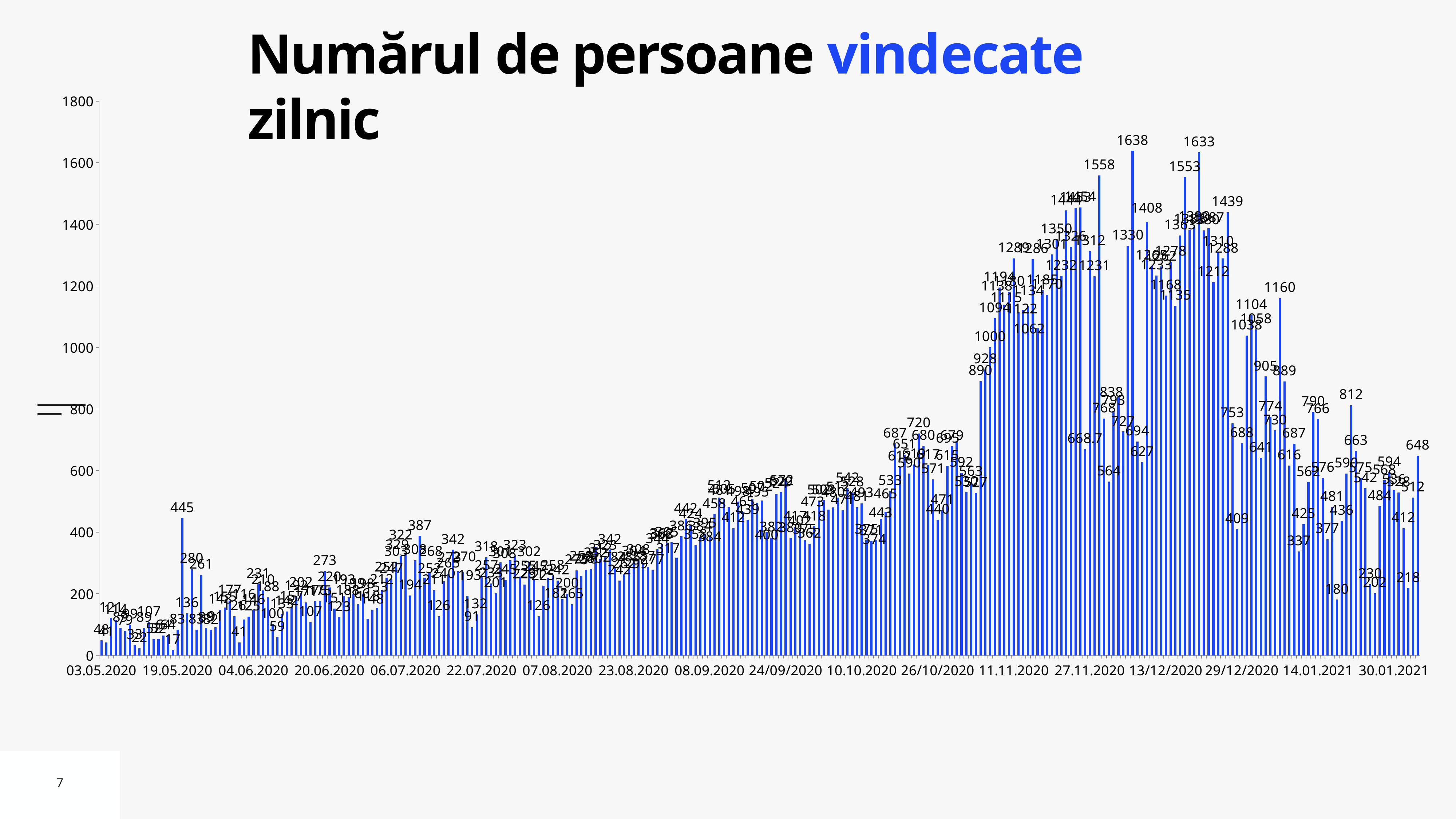
How many date labels are shown along the horizontal axis? 18 What is the difference between the highest labelled value (1638) and the rightmost bar (648)? 990 Is the value of the tallest bar in May 2020 greater or less than 400? greater What is the title of the chart? Numărul de persoane vindecate zilnic What is the difference between the two tallest bars, labelled 1638 and 1633? 5 What kind of chart is shown on the slide? bar chart What is the highest value labelled on the chart? 1638 Do the daily values generally rise or fall from May 2020 to December 2020? rise What is the value of the rightmost bar on the chart? 648 What is the maximum value shown on the vertical axis? 1800 What is the value of the tallest bar in May 2020 (between 03.05.2020 and 04.06.2020)? 445 Which is larger, the bar labelled 1638 or the bar labelled 1558? 1638